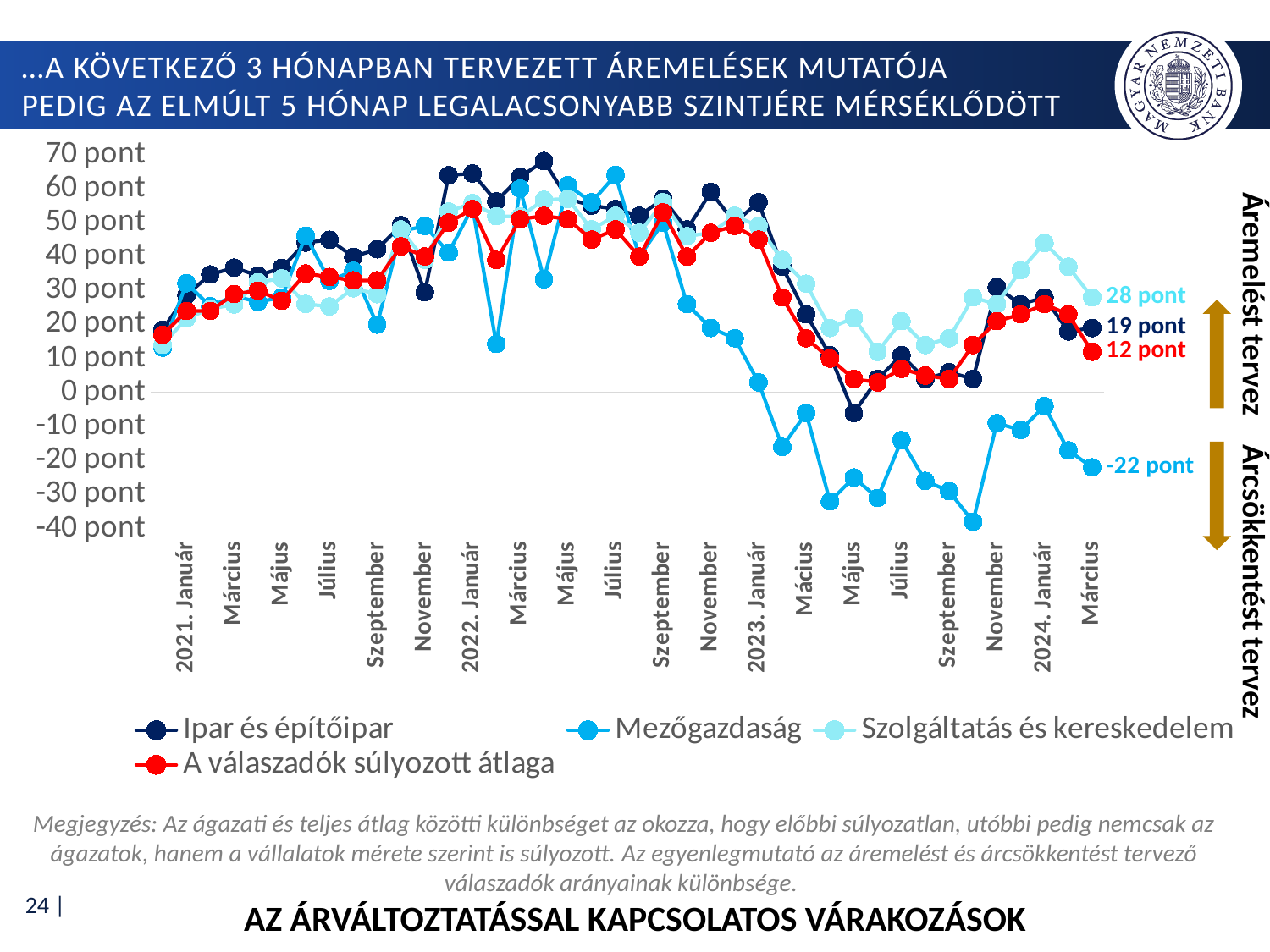
Is the value for Mezőgazdaság in 2023 Május greater or less than -20 pont? less What is the final (2024 Március) value for Mezőgazdaság? -22 pont Does the Mezőgazdaság series rise or fall between 2022 Szeptember and 2023 Május? fall What is the difference between the final values of Szolgáltatás és kereskedelem and Mezőgazdaság? 50 pont Which series has the lowest value at the end of the chart (2024 Március)? Mezőgazdaság At the end of the chart, which is larger: Ipar és építőipar or A válaszadók súlyozott átlaga? Ipar és építőipar What is the final (2024 Március) value for Szolgáltatás és kereskedelem? 28 pont What is the final (2024 Március) value for A válaszadók súlyozott átlaga? 12 pont What type of chart is shown on the slide? line chart What is the final (2024 Március) value for Ipar és építőipar? 19 pont Which series has the highest value at the end of the chart (2024 Március)? Szolgáltatás és kereskedelem How many series does the legend list? 4